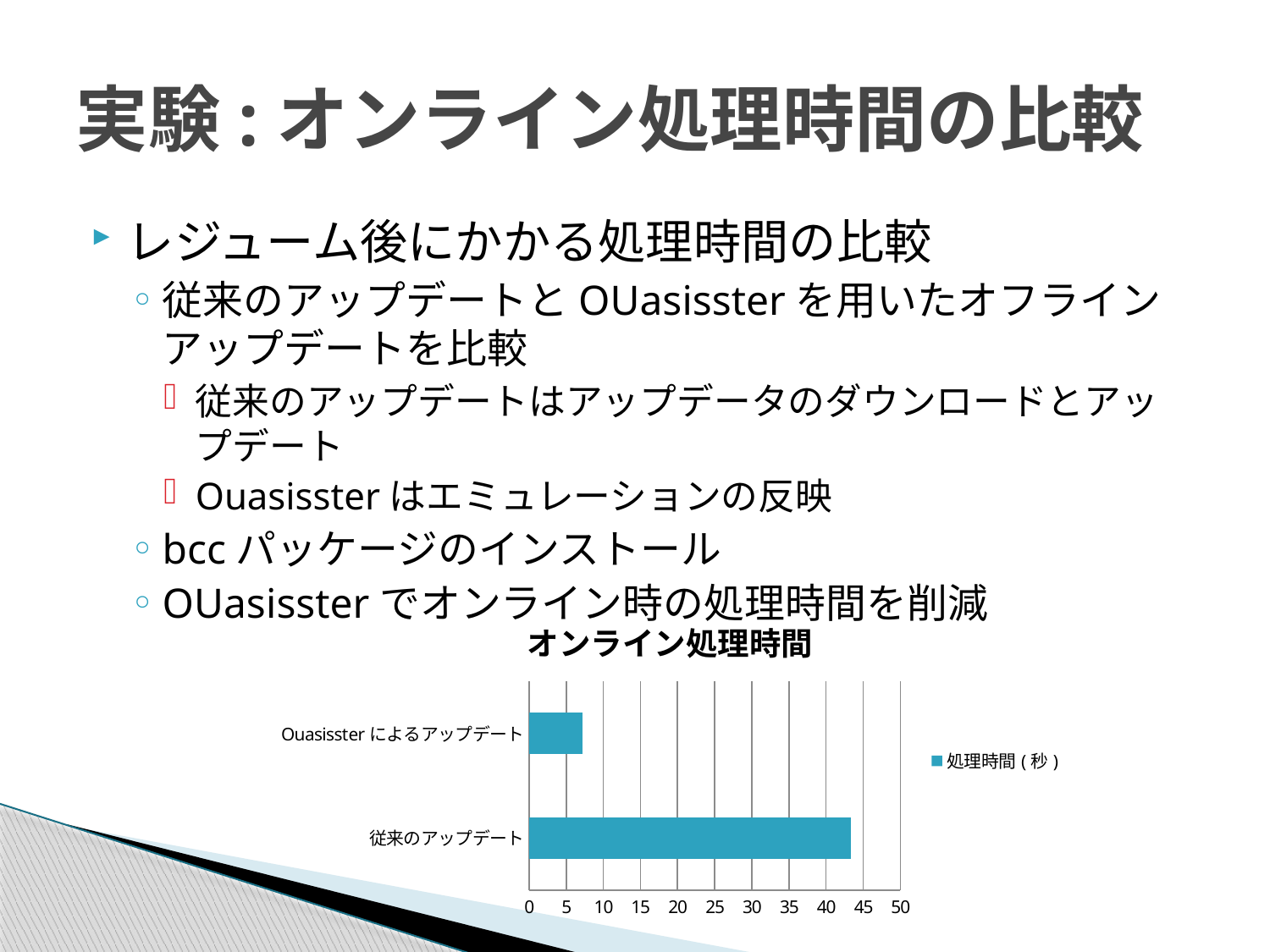
What is the title of the chart? オンライン処理時間 Which category has the highest value in the chart? 従来のアップデート Which is larger, the value for 従来のアップデート or the value for Ouasisster によるアップデート? 従来のアップデート How many categories are plotted in the chart? 2 Is the value for 従来のアップデート greater or less than 45? less How many series does the chart's legend list? 1 Is the value for 従来のアップデート greater or less than 40? greater What is the legend entry for the series in the chart? 処理時間 ( 秒 ) Is the value for Ouasisster によるアップデート greater or less than 5? greater Which category has the lowest value in the chart? Ouasisster によるアップデート What kind of chart is shown on the slide? bar chart